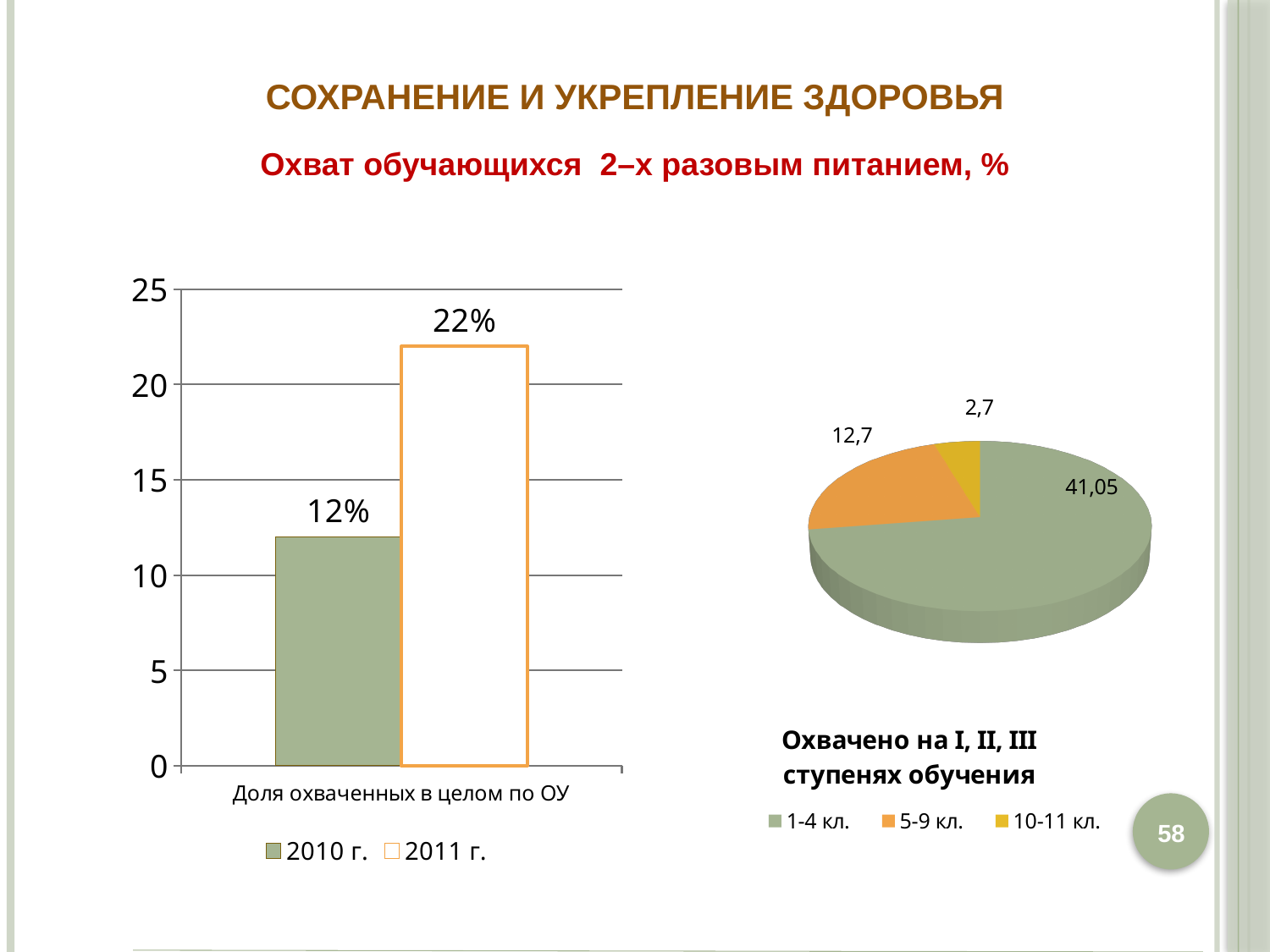
In the pie chart 'Охвачено на I, II, III ступенях обучения', what is the value for 5-9 кл.? 12,7 In the left bar chart, what is the value for 2011 г.? 22% In the pie chart 'Охвачено на I, II, III ступенях обучения', how many categories are shown? 3 In the left bar chart, what is the difference between the 2011 г. and 2010 г. values? 10% In the left bar chart, which year has the higher value, 2010 г. or 2011 г.? 2011 г. In the pie chart 'Охвачено на I, II, III ступенях обучения', which category has the largest slice? 1-4 кл. In the left bar chart, what is the value for 2010 г.? 12% In the pie chart 'Охвачено на I, II, III ступенях обучения', which category has the smallest slice? 10-11 кл. In the left bar chart, how many series does the legend list? 2 What kind of chart is the left chart? Bar chart What kind of chart is the right chart? Pie chart In the pie chart 'Охвачено на I, II, III ступенях обучения', what is the value for 1-4 кл.? 41,05